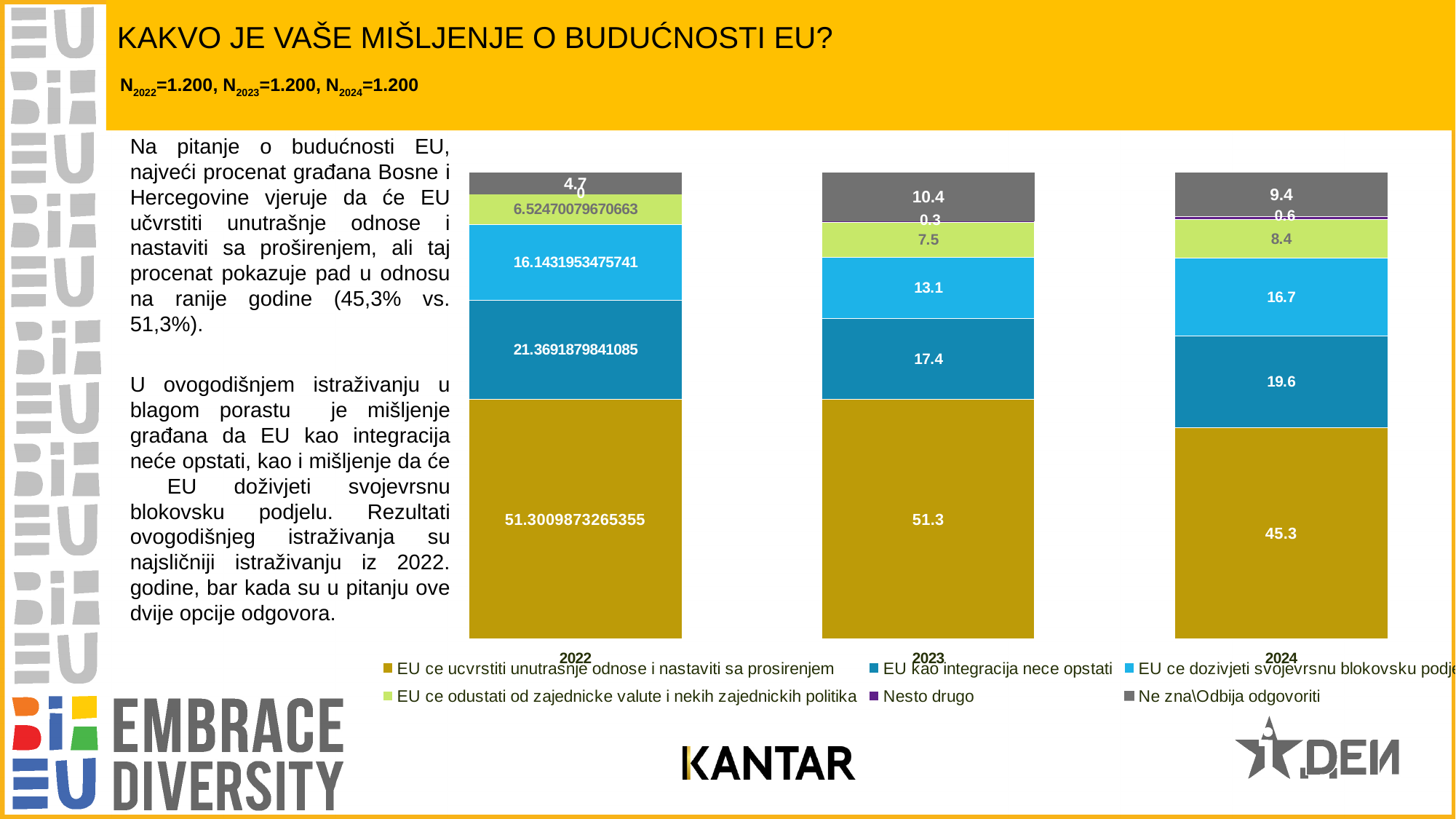
What is the difference between the 2023 and 2024 values for "EU ce ucvrstiti unutrasnje odnose i nastaviti sa prosirenjem"? 6.0 In which year is the value for "Ne zna\Odbija odgovoriti" highest? 2023 What is the value for "EU ce odustati od zajednicke valute i nekih zajednickih politika" in 2023? 7.5 In which year is the value for "EU ce ucvrstiti unutrasnje odnose i nastaviti sa prosirenjem" lowest? 2024 What is the value for "EU kao integracija nece opstati" in 2024? 19.6 How many years (categories) are shown on the x axis of the chart? 3 Does the value for "EU ce odustati od zajednicke valute i nekih zajednickih politika" rise or fall from 2022 to 2024? Rise What is the value for "Ne zna\Odbija odgovoriti" in 2023? 10.4 Which year has the larger value for "EU ce dozivjeti svojevrsnu blokovsku podjelu", 2023 or 2024? 2024 What is the value for "EU ce ucvrstiti unutrasnje odnose i nastaviti sa prosirenjem" in 2024? 45.3 What kind of chart is shown on the slide? Stacked bar chart How many series does the legend list? 6